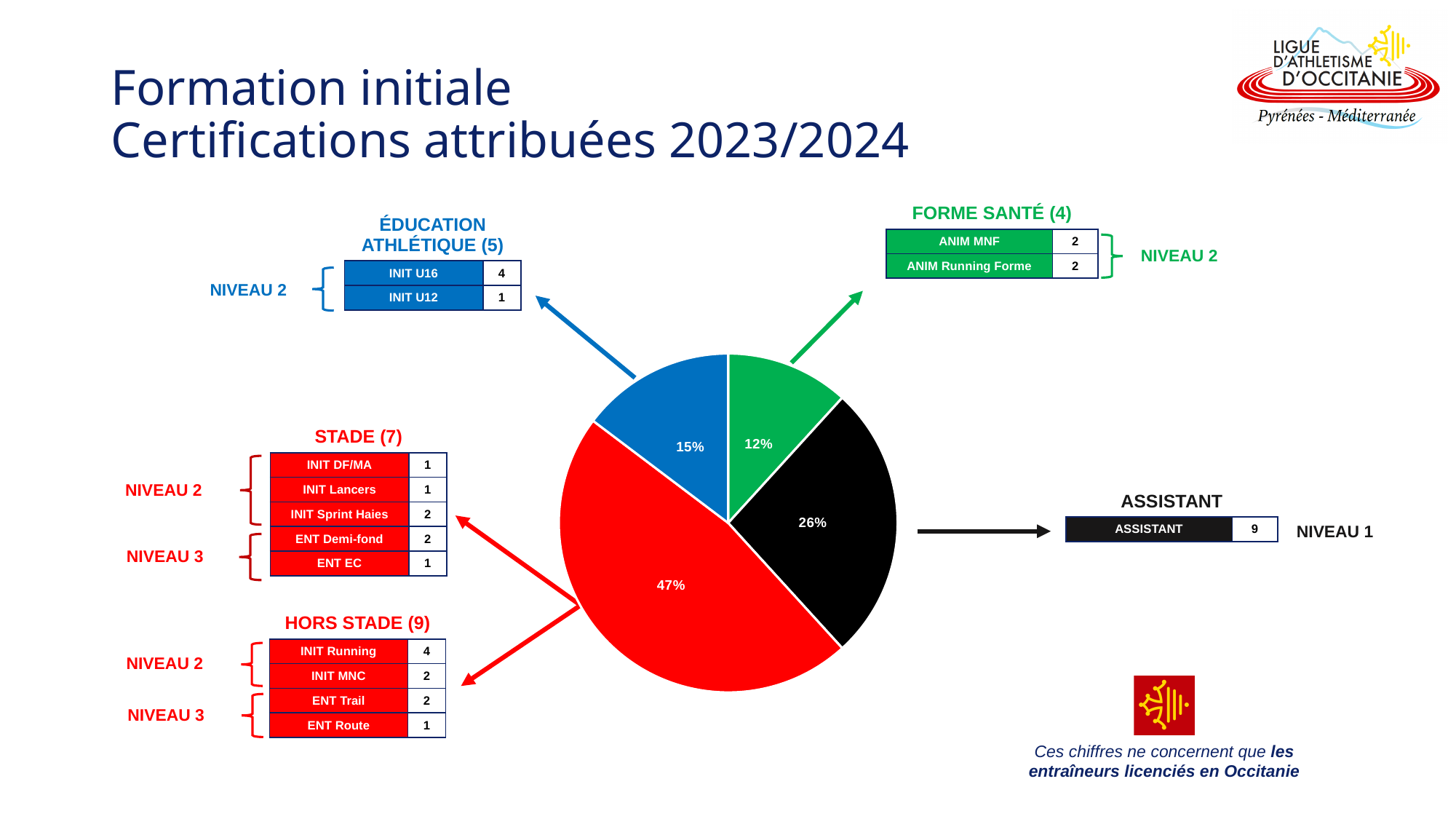
Which slice of the pie chart has the largest share? the red slice (47%) Which category does the green slice of the pie chart point to? FORME SANTÉ (4) What percentage is shown on the green slice of the pie chart? 12% Which is larger in the pie chart, the blue slice or the green slice? the blue slice What percentage is shown on the red slice of the pie chart? 47% What percentage is shown on the black slice of the pie chart? 26% What is the difference in percentage points between the red slice and the black slice of the pie chart? 21 What percentage is shown on the blue slice of the pie chart? 15% Which colour slice of the pie chart does the arrow to the ASSISTANT box come from? black Which slice of the pie chart has the smallest share? the green slice (12%) What kind of chart is shown in the centre of the slide? pie chart How many slices does the pie chart have? 4